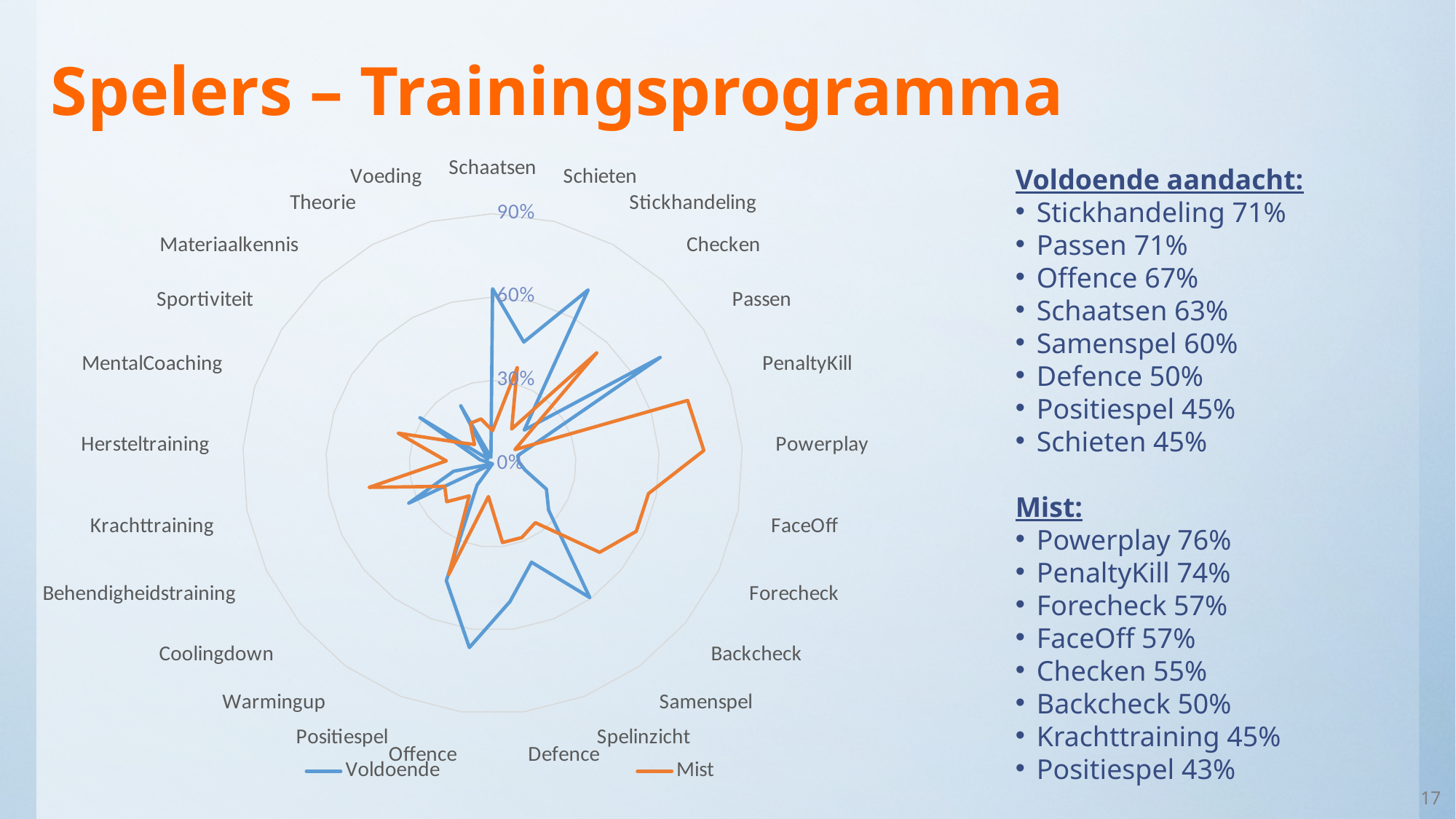
What is the Voldoende value for Stickhandeling? 71% Is the Mist value for Powerplay greater or less than 60%? greater How many series does the chart legend list? 2 Which category has the highest value for the Mist series? Powerplay What kind of chart is shown on the slide? Radar chart Which two series are listed in the chart legend? Voldoende and Mist What is the difference between the Mist values for Powerplay and PenaltyKill? 2 percentage points What is the Mist value for Powerplay? 76% What is the highest percentage tick shown on the chart's axis? 90% Is the Mist value for Positiespel greater or less than 30%? greater How many categories are plotted around the radar chart? 25 Which is larger for the Mist series: Powerplay or Forecheck? Powerplay